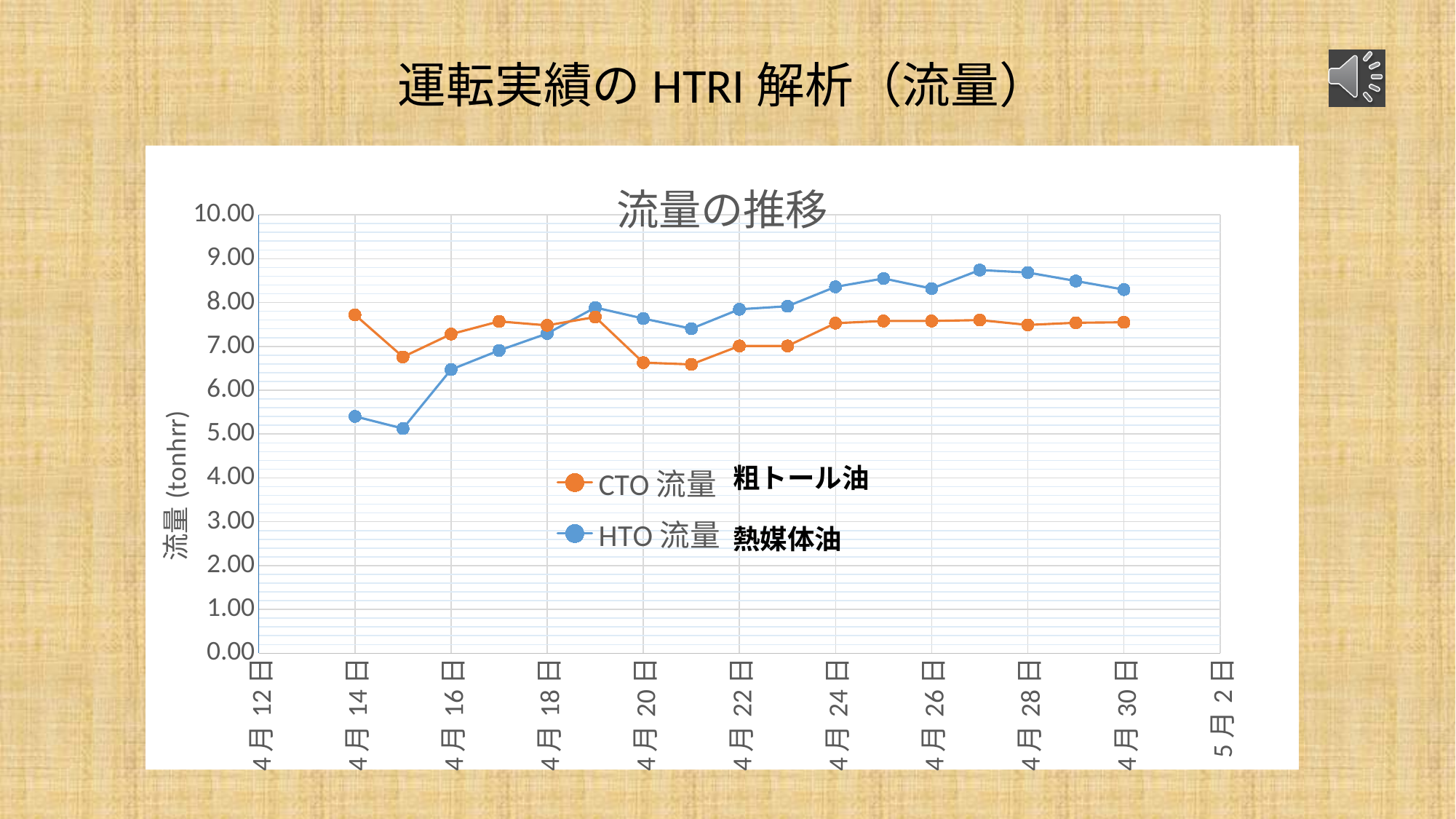
Is the value for CTO 流量 on 4月14日 greater or less than 7.00? greater Is the value for CTO 流量 on 4月20日 greater or less than 7.00? less On 4月30日, which series has the larger value, CTO 流量 or HTO 流量? HTO 流量 How many series does the legend list? 2 On 4月14日, which series has the larger value, CTO 流量 or HTO 流量? CTO 流量 Is the value for HTO 流量 on 4月27日 greater or less than 8.00? greater On which date is the HTO 流量 value lowest? 4月15日 What kind of chart is shown on the slide? line chart What is the title of the chart? 流量の推移 Which colour is used for the HTO 流量 series? blue How many data points are plotted for the HTO 流量 series? 17